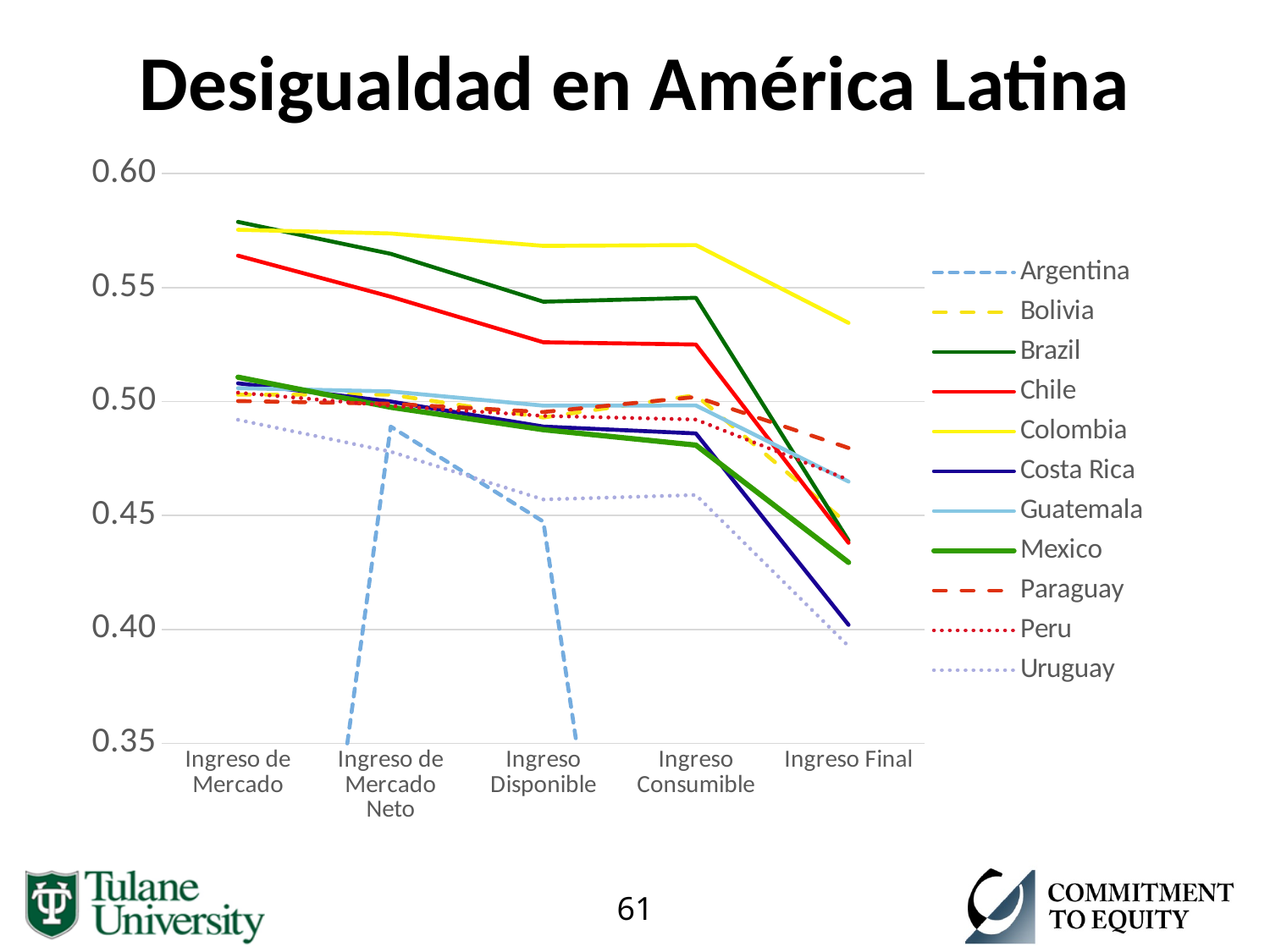
Is the value for Brazil at Ingreso de Mercado greater or less than 0.55? greater Is the value for Colombia at Ingreso Final greater or less than 0.50? greater Does the Colombia line rise or fall from Ingreso de Mercado to Ingreso Final? fall Is the value for Uruguay at Ingreso Consumible greater or less than 0.50? less How many categories are shown on the x axis? 5 What is the title of the chart? Desigualdad en América Latina At Ingreso Final, which is higher, Chile or Costa Rica? Chile How many series does the legend list? 11 What kind of chart is shown on the slide? line chart At Ingreso Consumible, which is higher, Chile or Colombia? Colombia Which country has the highest value at Ingreso Final? Colombia